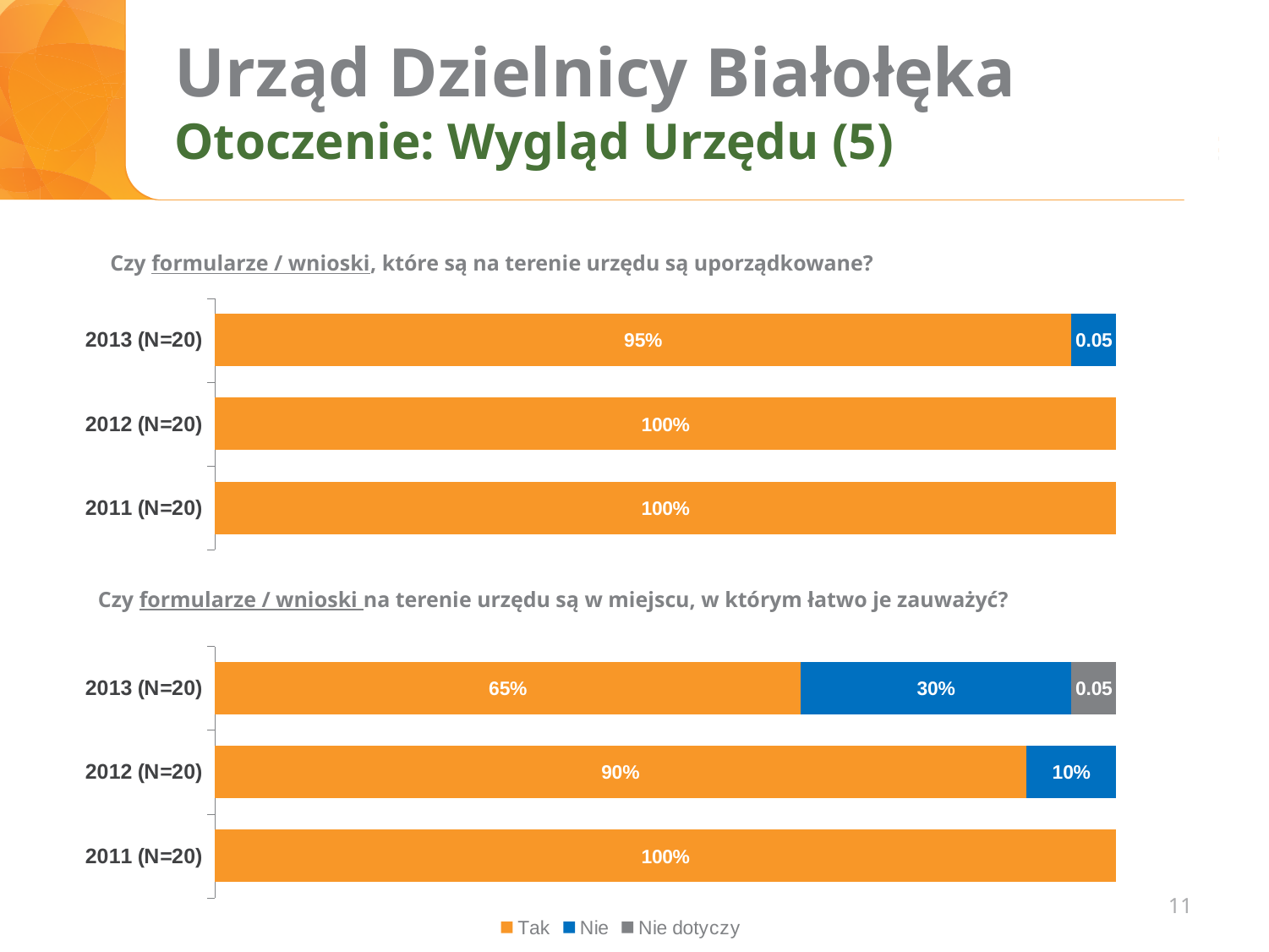
In the bottom chart, does the 'Tak' value rise or fall from 2011 to 2013? fall In the bottom chart, what is the difference between the 'Tak' values for 2012 (N=20) and 2013 (N=20)? 25% In the bottom chart, what is the 'Nie' value for 2012 (N=20)? 10% In the bottom chart, which year has the lowest 'Tak' value? 2013 (N=20) In the bottom chart, is the 'Tak' value for 2012 (N=20) larger or smaller than the 'Tak' value for 2013 (N=20)? larger In the top chart, what label is shown on the blue segment for 2013 (N=20)? 0.05 In the bottom chart, what is the 'Nie' value for 2013 (N=20)? 30% What type of chart is the bottom chart? Stacked bar chart In the bottom chart, what is the 'Tak' value for 2013 (N=20)? 65% In the top chart, what is the 'Tak' value for 2013 (N=20)? 95% How many series does the legend at the bottom of the slide list? 3 In the top chart, what is the 'Tak' value for 2012 (N=20)? 100%